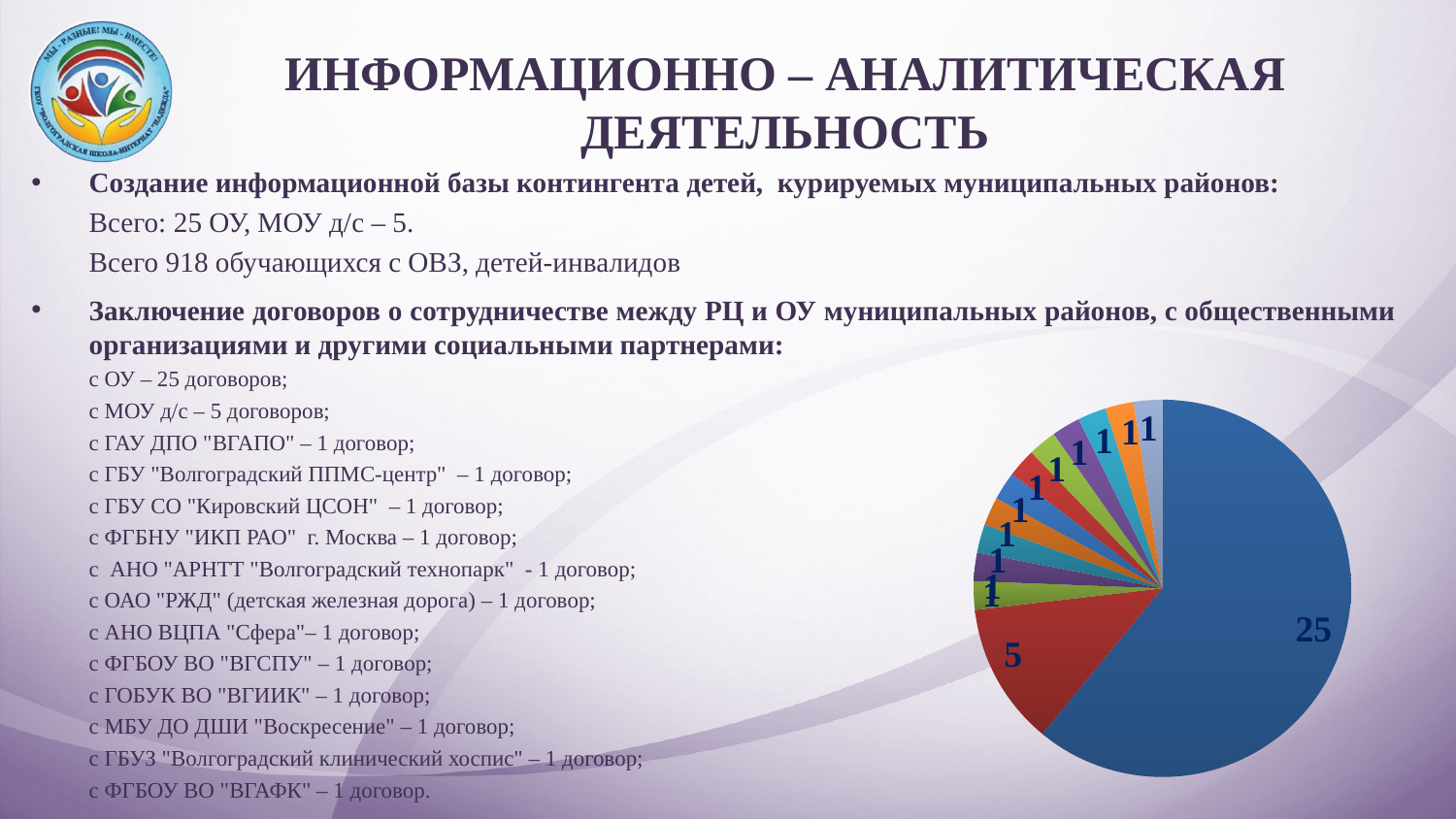
What is the value of the largest slice in the pie chart? 25 What kind of chart is shown on the slide? pie chart How many slices does the pie chart have in total? 13 What is the difference between the largest slice (25) and the second-largest slice (5) in the pie chart? 20 What colour is the slice labelled 5 in the pie chart? red What is the value of the second-largest slice in the pie chart? 5 Which is larger in the pie chart: the blue slice or the red slice? the blue slice Is the value of the largest slice in the pie chart greater or less than 20? greater What is the value shown on each of the smallest slices of the pie chart? 1 How many slices in the pie chart are labelled 1? 11 What is the sum of all the values shown in the pie chart? 41 What colour is the largest slice of the pie chart? blue